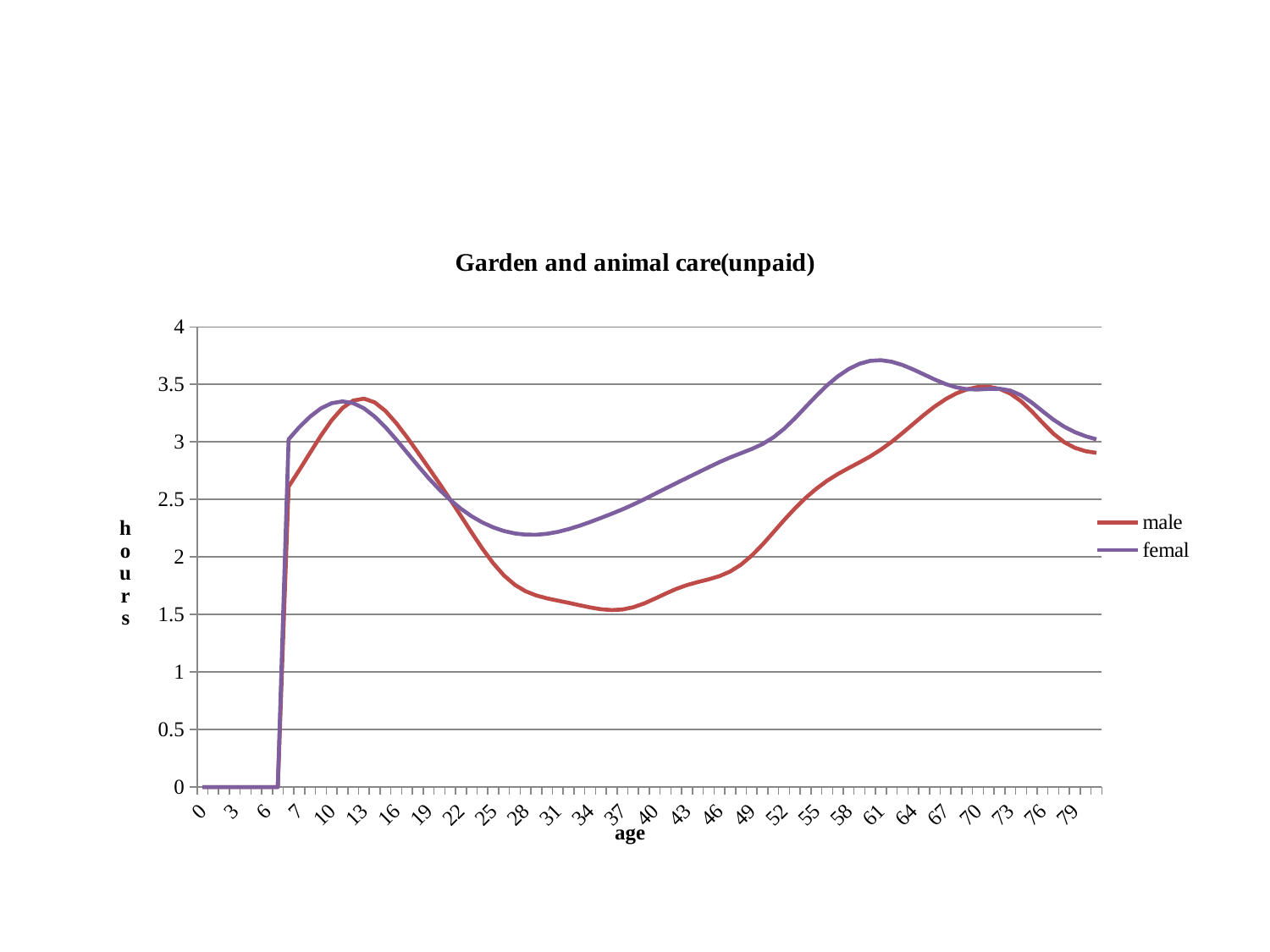
What is the value for male at age 0? 0 What kind of chart is shown on the slide? line chart Is the value for male at age 13 greater or less than 3? greater At age 61, which series has the higher value, male or femal? femal At age 37, which series has the higher value, male or femal? femal Is the value for male at age 37 greater or less than 2? less What is the title of the chart? Garden and animal care(unpaid) What is the value for femal at age 3? 0 Is the value for femal at age 61 greater or less than 3.5? greater Does the male line rise or fall between age 37 and age 70? rise What label is shown on the x axis of the chart? age How many series does the legend list? 2